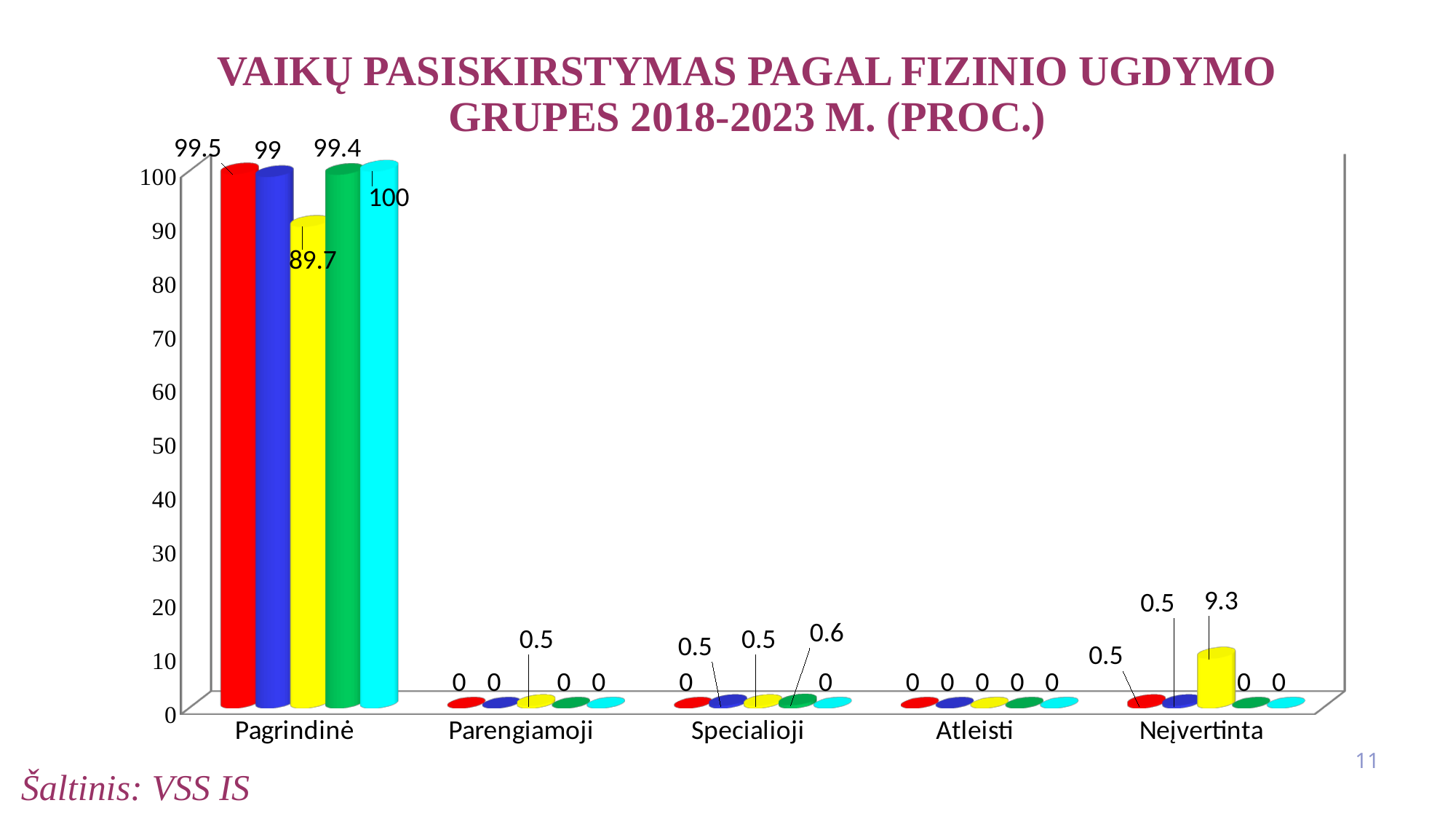
What is the value of the yellow bar for Pagrindinė? 89.7 What is the value of the cyan bar for Pagrindinė? 100 What is the title of the chart? VAIKŲ PASISKIRSTYMAS PAGAL FIZINIO UGDYMO GRUPES 2018-2023 M. (PROC.) Which category has the highest values in the chart? Pagrindinė What kind of chart is shown on the slide? bar chart How many categories are shown on the x axis of the chart? 5 Is the value of the yellow bar for Pagrindinė greater or less than 90? less What is the value of the green bar for Specialioji? 0.6 What is the value of the yellow bar for Neįvertinta? 9.3 Which is larger for Pagrindinė, the red bar or the yellow bar? the red bar What is the difference between the cyan bar and the yellow bar for Pagrindinė? 10.3 What is the value of the red bar for Pagrindinė? 99.5